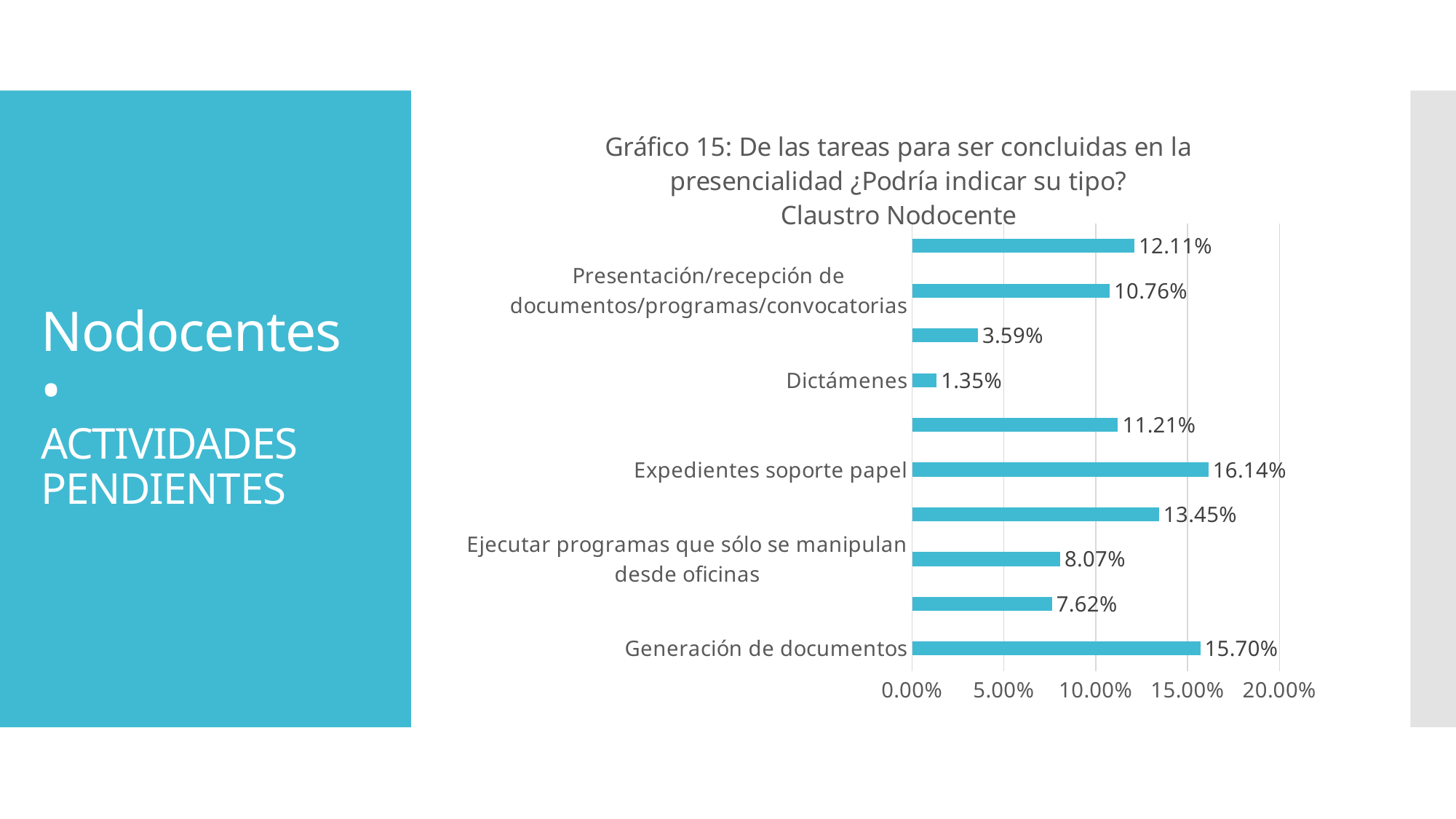
How many bars are plotted in the chart? 10 What is the value for Presentación/recepción de documentos/programas/convocatorias? 10.76% What is the highest value printed on the chart? 16.14% What is the value for Generación de documentos? 15.70% Which labelled category has the lowest value? Dictámenes What is the difference between the values for Expedientes soporte papel and Generación de documentos? 0.44% Which is larger, the value for Dictámenes or the value for Ejecutar programas que sólo se manipulan desde oficinas? Ejecutar programas que sólo se manipulan desde oficinas What is the value for Dictámenes? 1.35% What is the value for Ejecutar programas que sólo se manipulan desde oficinas? 8.07% What is the value for Expedientes soporte papel? 16.14% Which labelled category has the highest value? Expedientes soporte papel What kind of chart is shown on the slide? Bar chart